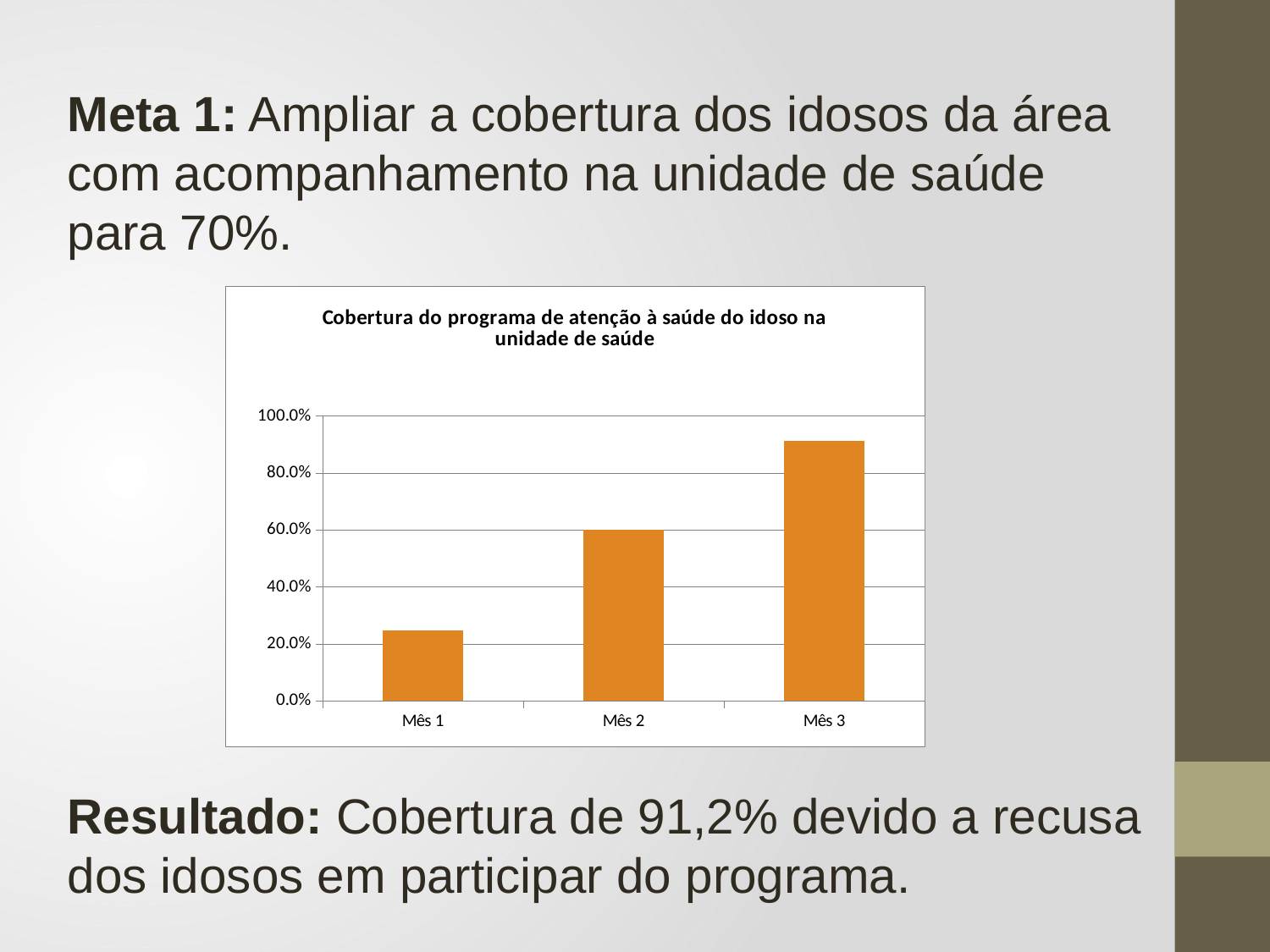
How many categories (months) are plotted on the x axis of the chart? 3 What is the title of the chart? Cobertura do programa de atenção à saúde do idoso na unidade de saúde Is the value for Mês 2 greater or less than 40.0%? greater Which is larger, the value for Mês 2 or the value for Mês 3? Mês 3 Which month has the highest coverage in the chart? Mês 3 Which month has the lowest coverage in the chart? Mês 1 Is the value for Mês 1 greater or less than 40.0%? less What colour are the bars in the chart? orange Is the value for Mês 3 greater or less than 80.0%? greater Do the values rise or fall from Mês 1 to Mês 3? rise What kind of chart is shown on the slide? bar chart